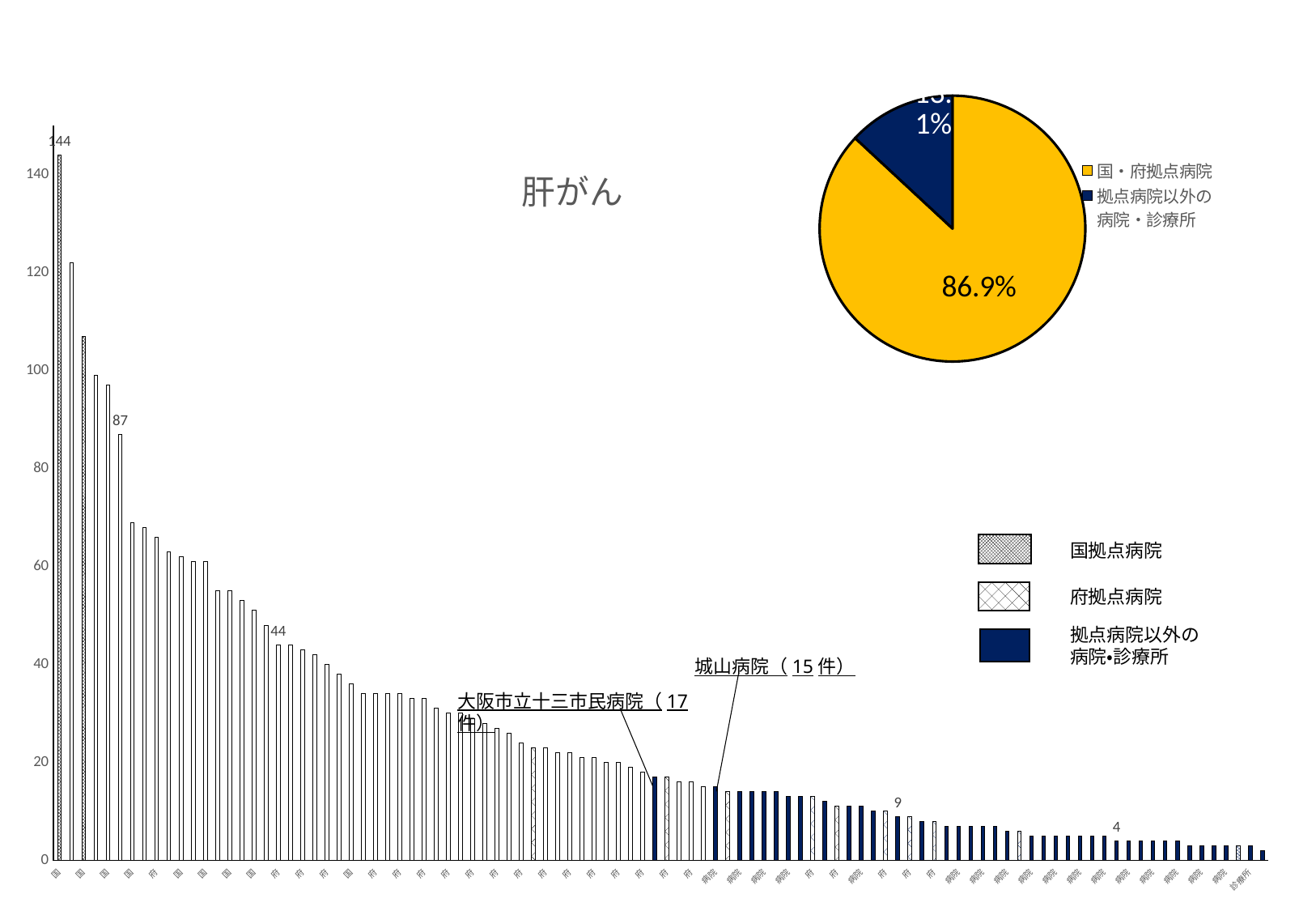
How many series does the legend of the bar chart list? 3 In the bar chart, what is the difference between the tallest bar (144) and the bar labelled 87? 57 In the pie chart, which slice is larger, 国・府拠点病院 or 拠点病院以外の病院・診療所? 国・府拠点病院 In the bar chart, which has the larger value, 大阪市立十三市民病院 or 城山病院? 大阪市立十三市民病院 In the bar chart, how many cases are annotated for 城山病院? 15件 What is the title shown above the bar chart? 肝がん In the bar chart, what is the value of the tallest bar? 144 In the pie chart, what share is shown for 国・府拠点病院? 86.9% In the bar chart, do the values rise or fall from left to right along the x axis? fall In the bar chart, how many cases are annotated for 大阪市立十三市民病院? 17件 What kind of chart is the large chart on the left of the slide? bar chart In the bar chart, what is the difference between the values for 大阪市立十三市民病院 and 城山病院? 2